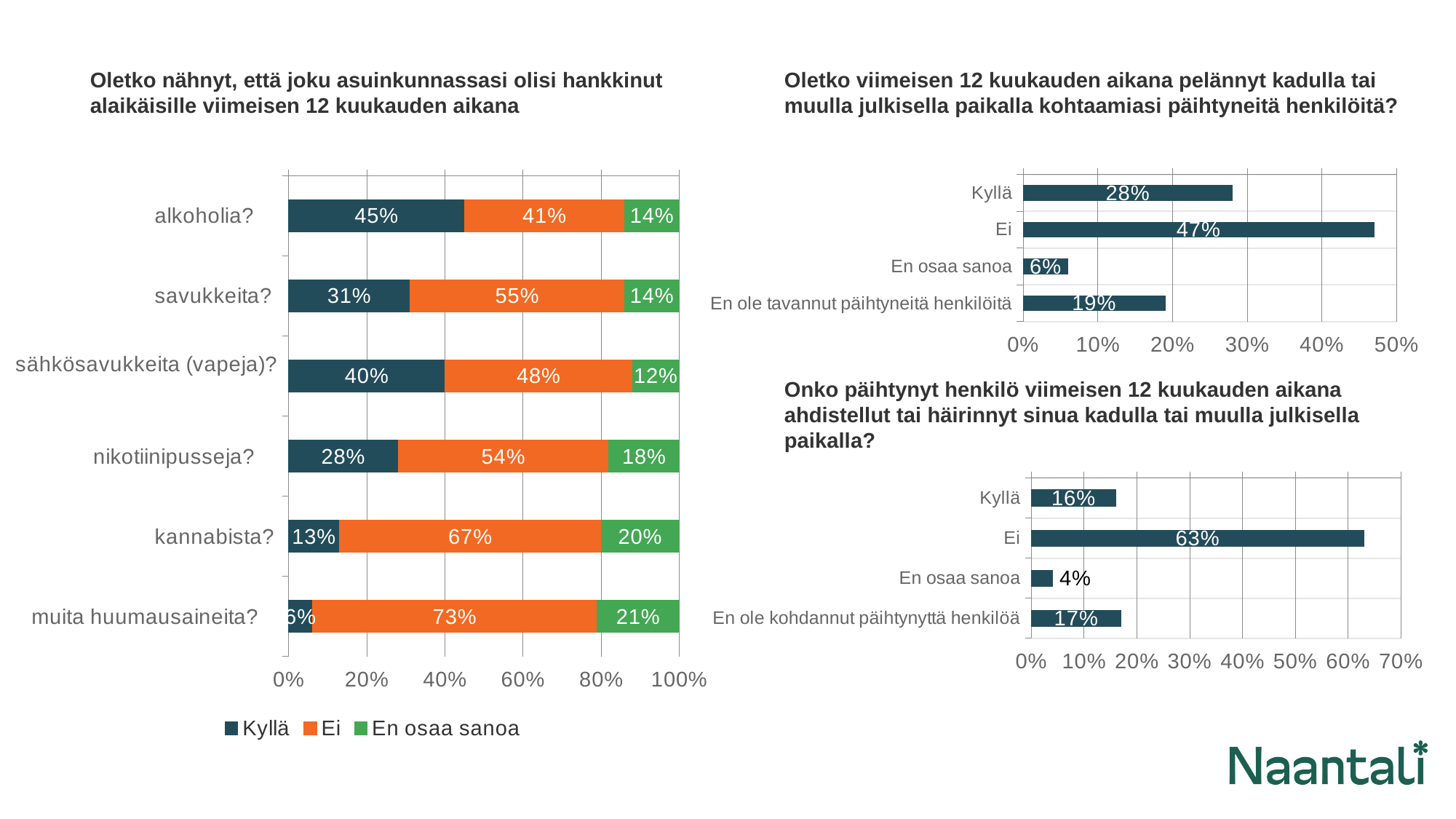
In the left chart, what is the difference between the Ei values for savukkeita and nikotiinipusseja? 1% In the left chart, how many categories are shown? 6 In the left chart, which category has the lowest Kyllä value? muita huumausaineita? In the top right chart, which category has the lowest value? En osaa sanoa What kind of chart is the bottom right chart? bar chart In the top right chart ("Oletko viimeisen 12 kuukauden aikana pelännyt..."), what is the value for Ei? 47% In the left chart ("Oletko nähnyt, että joku asuinkunnassasi olisi hankkinut alaikäisille..."), what is the Kyllä value for alkoholia? 45% In the left chart, how many series does the legend list? 3 In the left chart, which category has the highest Kyllä value? alkoholia? In the bottom right chart ("Onko päihtynyt henkilö viimeisen 12 kuukauden aikana ahdistellut..."), what is the value for Kyllä? 16% In the left chart, what is the Ei value for kannabista? 67% In the bottom right chart, what is the difference between the Ei and Kyllä values? 47%